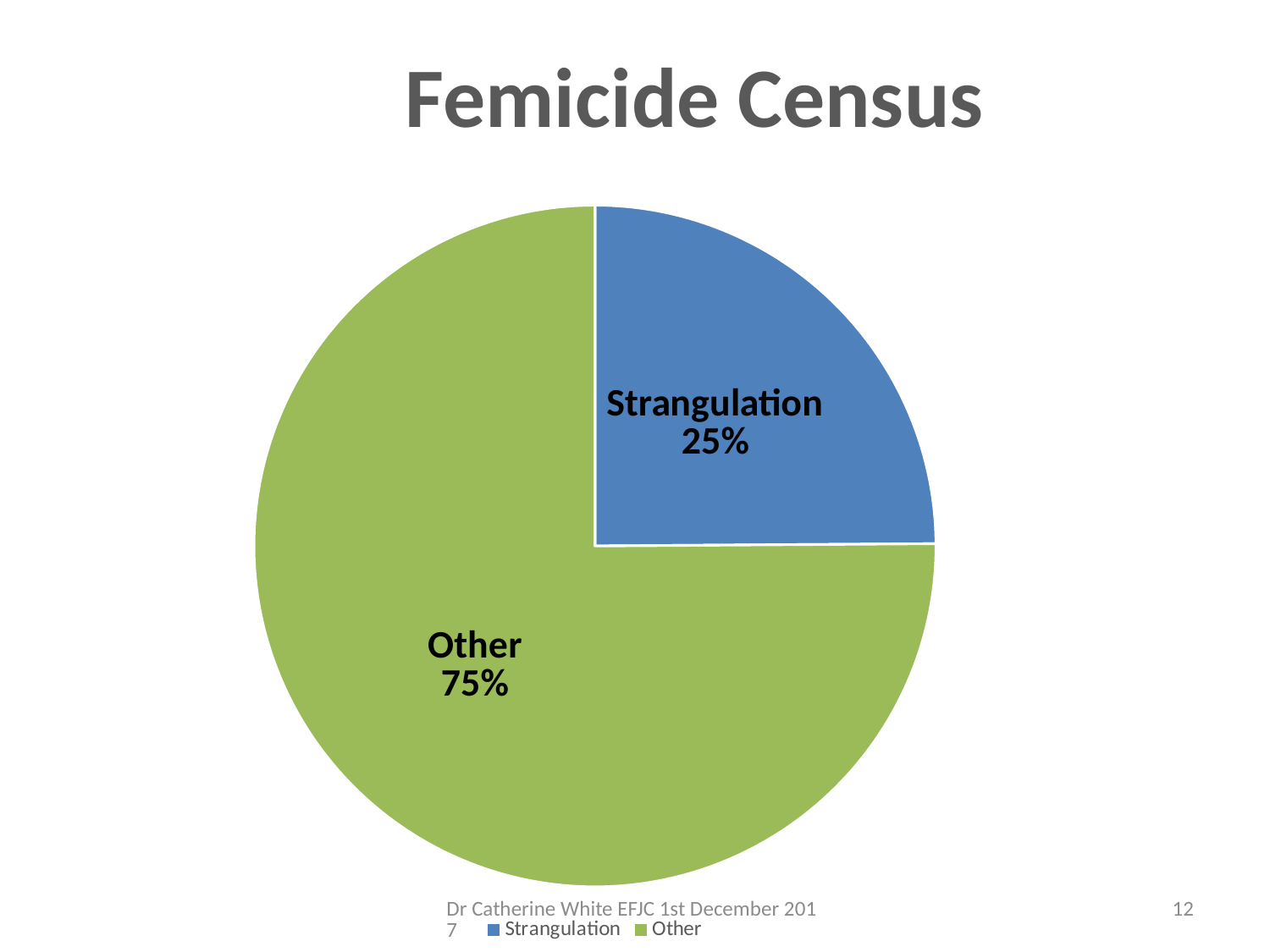
Which slice of the pie is the smallest? Strangulation What kind of chart is shown on the slide? pie chart What is the difference in percentage points between the Other slice and the Strangulation slice? 50 What share of the pie does Other represent? 75% What is the title of the slide containing the pie chart? Femicide Census How many slices does the pie chart have? 2 Which slice of the pie is the largest? Other What colour is the Strangulation slice? blue What share of the pie does Strangulation represent? 25% Which is larger, the Strangulation slice or the Other slice? Other How many entries does the legend list? 2